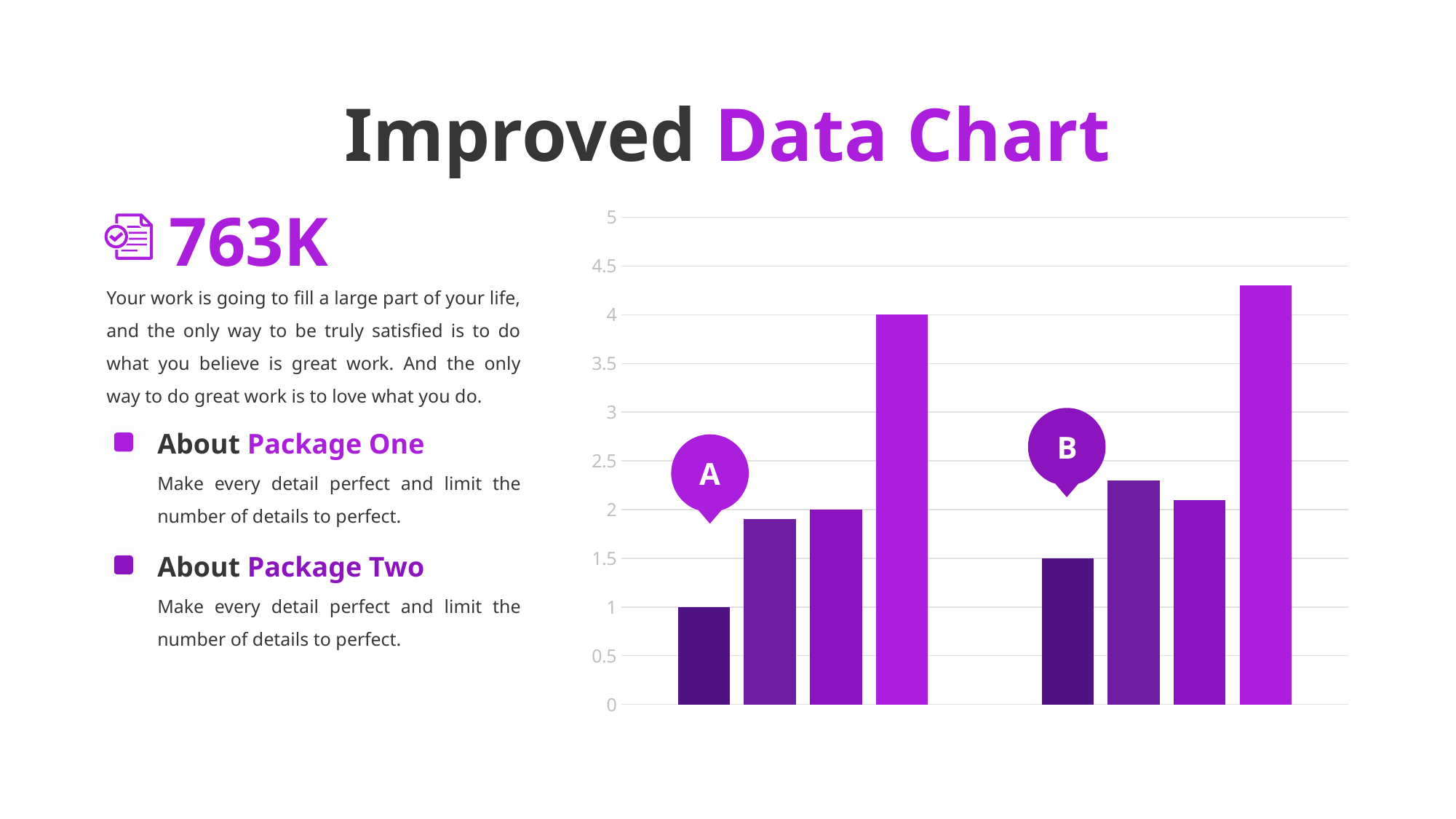
Which group contains the tallest bar on the chart, A or B? B What is the value of the third bar in group A? 2 How many bars are in group A? 4 What is the value of the fourth (lightest) bar in group A? 4 How many labelled groups of bars does the chart show? 2 Is the value of the second bar in group A greater or less than 2? less Is the value of the fourth (lightest) bar in group B greater or less than 4? greater Which is larger: the first bar in group A or the first bar in group B? the first bar in group B What is the value of the first (darkest) bar in group A? 1 What is the value of the first (darkest) bar in group B? 1.5 What kind of chart is shown on the slide? bar chart What is the difference between the fourth bar and the first bar in group A? 3